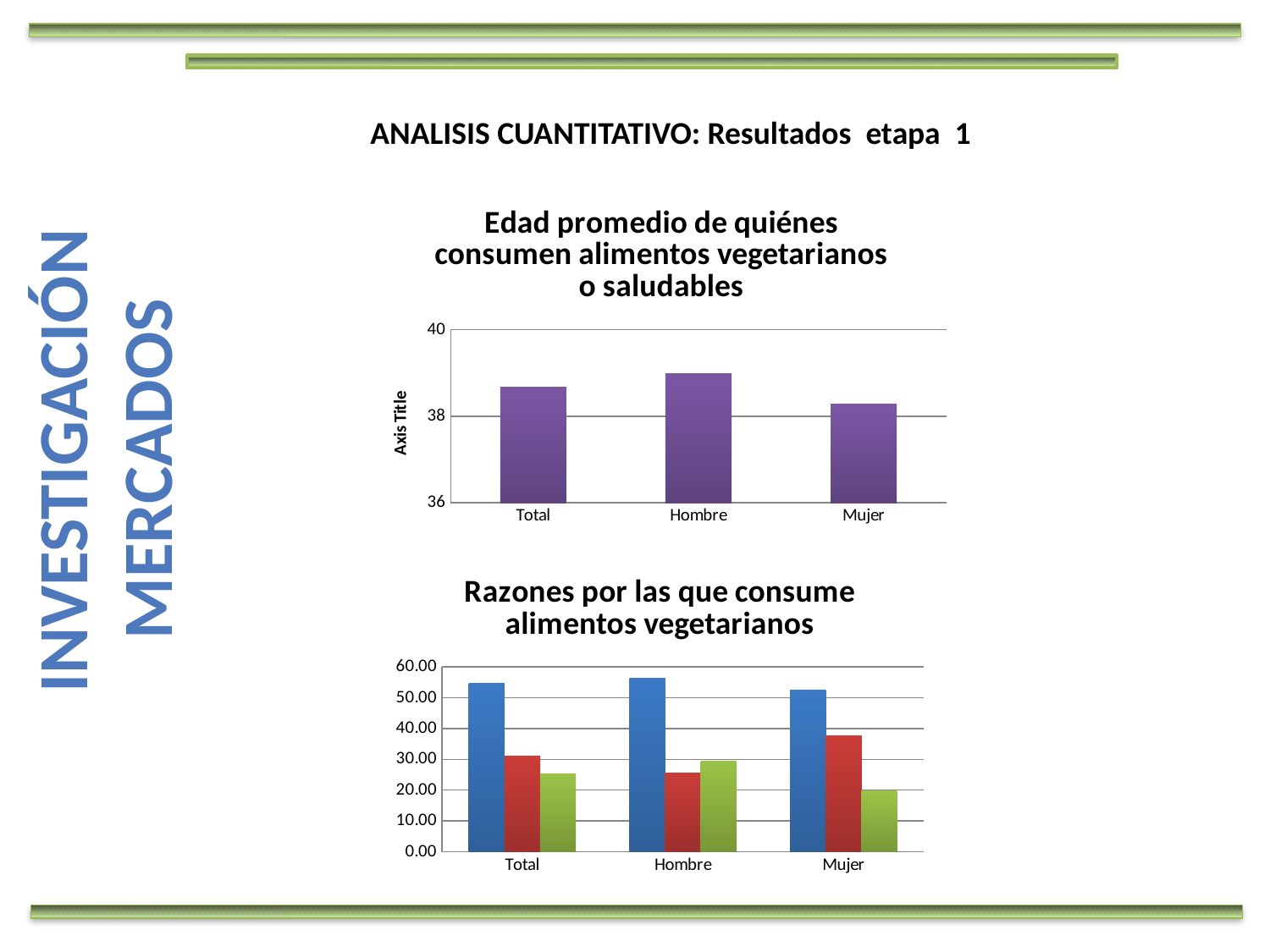
In the top chart 'Edad promedio de quiénes consumen alimentos vegetarianos o saludables', which category has the lowest bar? Mujer What is the label on the vertical axis of the top chart 'Edad promedio de quiénes consumen alimentos vegetarianos o saludables'? Axis Title In the top chart 'Edad promedio de quiénes consumen alimentos vegetarianos o saludables', which category has the highest bar? Hombre In the top chart 'Edad promedio de quiénes consumen alimentos vegetarianos o saludables', how many categories are shown on the x axis? 3 What type of chart is the top chart titled 'Edad promedio de quiénes consumen alimentos vegetarianos o saludables'? bar chart In the bottom chart 'Razones por las que consume alimentos vegetarianos', is the blue bar for Total greater or less than 50.00? greater In the bottom chart 'Razones por las que consume alimentos vegetarianos', which is larger for Hombre, the blue bar or the red bar? the blue bar In the top chart 'Edad promedio de quiénes consumen alimentos vegetarianos o saludables', is the value for Mujer greater or less than 38? greater In the top chart 'Edad promedio de quiénes consumen alimentos vegetarianos o saludables', is the value for Hombre greater or less than 40? less What type of chart is the bottom chart titled 'Razones por las que consume alimentos vegetarianos'? bar chart In the bottom chart 'Razones por las que consume alimentos vegetarianos', how many bars are shown for each category? 3